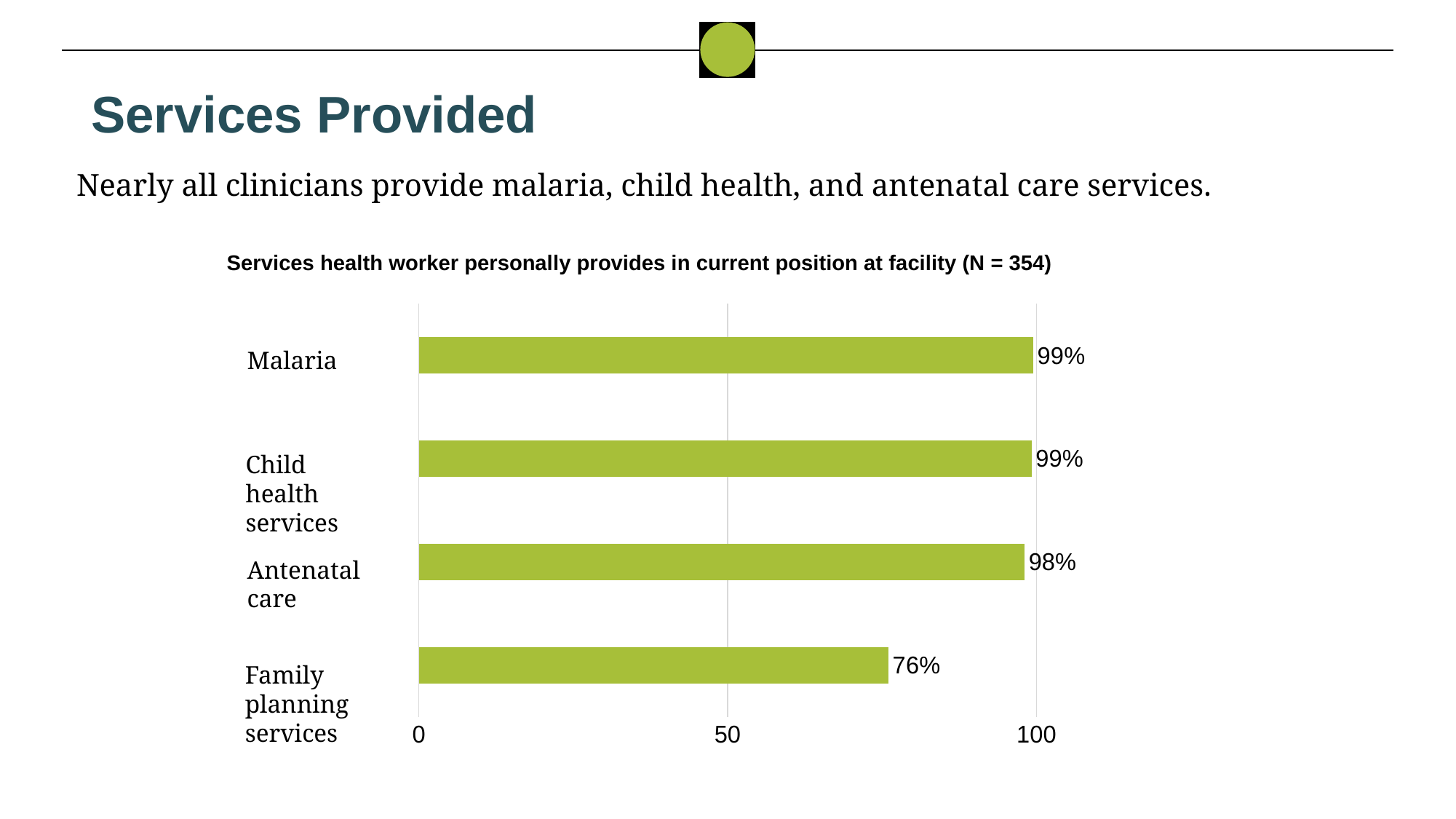
Which is larger, the value for antenatal care or the value for family planning services? Antenatal care What is the difference in percentage points between malaria and antenatal care? 1 What is the value shown for family planning services? 76% What kind of chart is shown on the slide? Bar chart What percentage of health workers provide antenatal care? 98% Which service has the lowest percentage of health workers providing it? Family planning services How many services are shown in the chart? 4 What is the sample size (N) given in the chart title? 354 Is the value for family planning services greater or less than 50? greater What percentage of health workers personally provide malaria services? 99% What is the difference in percentage points between antenatal care and family planning services? 22 What is the value shown for child health services? 99%